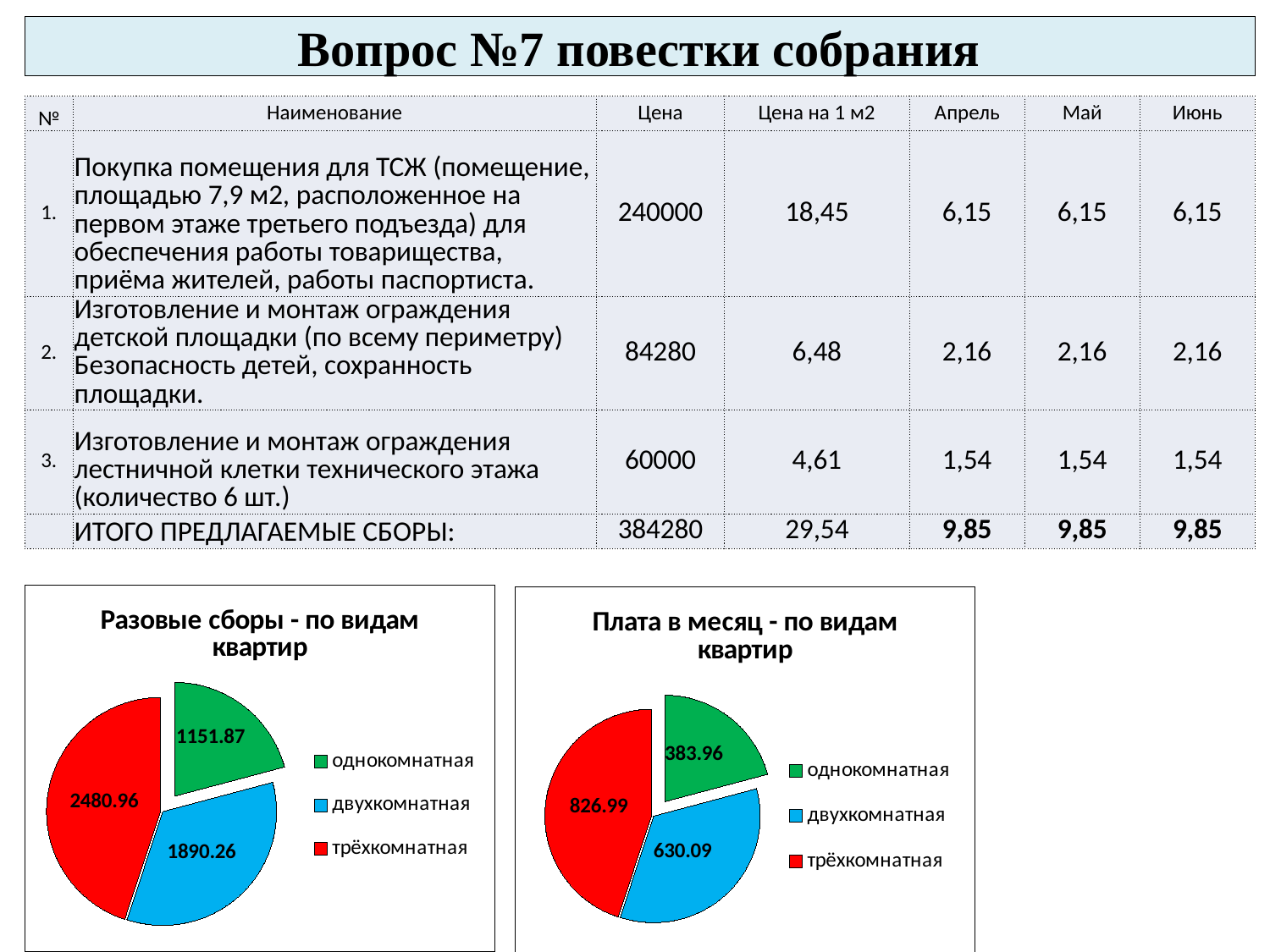
In the chart 'Плата в месяц - по видам квартир', what is the difference between the values for трёхкомнатная and однокомнатная? 443.03 In the chart 'Разовые сборы - по видам квартир', what is the difference between the values for трёхкомнатная and однокомнатная? 1329.09 What type of chart is 'Плата в месяц - по видам квартир'? pie chart In the chart 'Плата в месяц - по видам квартир', what is the total of all slices? 1841.04 In the chart 'Разовые сборы - по видам квартир', what colour is the slice for двухкомнатная? blue In the chart 'Плата в месяц - по видам квартир', which apartment type has the smallest slice? однокомнатная How many slices does the chart 'Разовые сборы - по видам квартир' have? 3 In the chart 'Плата в месяц - по видам квартир', which is larger: двухкомнатная or однокомнатная? двухкомнатная In the chart 'Разовые сборы - по видам квартир', what is the value for двухкомнатная? 1890.26 In the chart 'Разовые сборы - по видам квартир', which apartment type has the largest slice? трёхкомнатная In the chart 'Разовые сборы - по видам квартир', what is the total of all slices? 5523.09 In the chart 'Плата в месяц - по видам квартир', what is the value for трёхкомнатная? 826.99